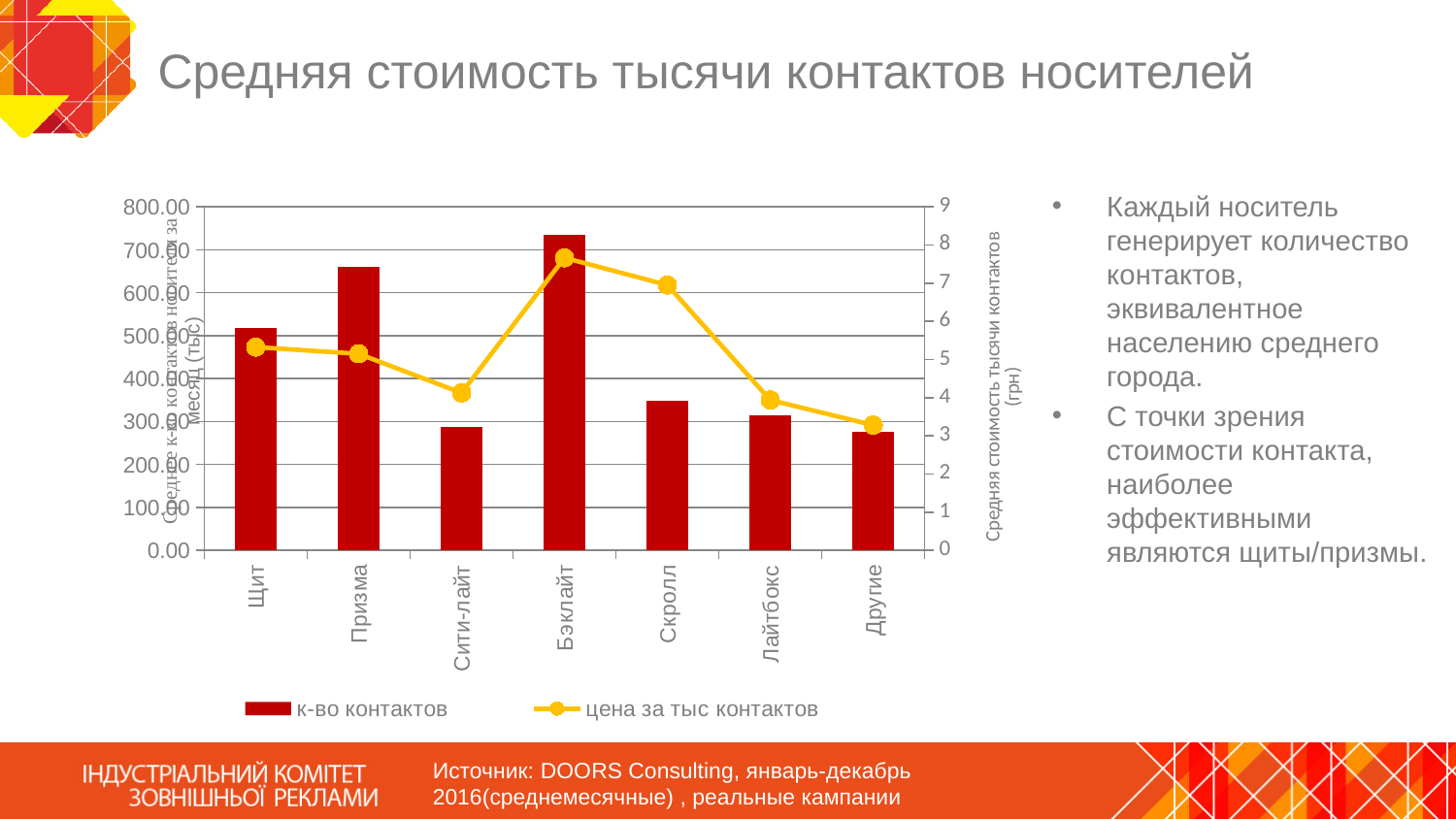
Is the к-во контактов value for Скролл greater or less than 400? less Which category has the lowest value for цена за тыс контактов? Другие Which has the larger к-во контактов bar, Щит or Призма? Призма Which category has the highest bar for к-во контактов? Бэклайт What type of chart is shown on the slide? A combined bar and line chart Is the цена за тыс контактов value for Бэклайт greater or less than 7? greater Which category has the highest value for цена за тыс контактов? Бэклайт Which series is drawn as a line with markers in the chart? цена за тыс контактов Is the к-во контактов value for Призма greater or less than 600? greater How many categories are shown on the x axis of the chart? 7 How many series does the chart legend list? 2